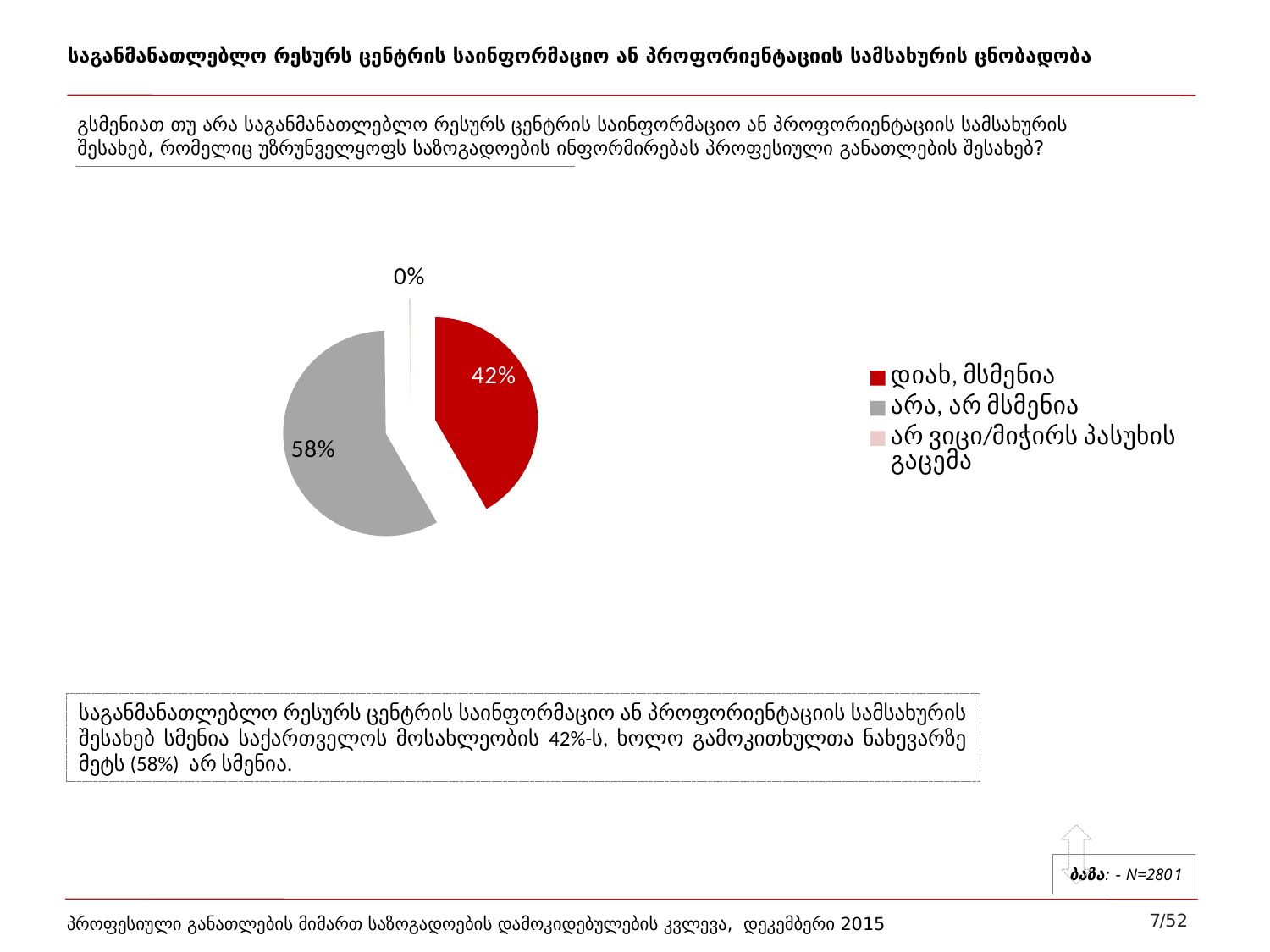
How many entries does the legend list? 3 How many categories does the pie chart show? 3 What percentage is shown for "არ ვიცი/მიჭირს პასუხის გაცემა"? 0% What type of chart is shown on the slide? Pie chart What percentage of the pie chart is labelled "არა, არ მსმენია"? 58% What percentage of the pie chart is labelled "დიახ, მსმენია"? 42% What colour is the slice for "არა, არ მსმენია"? Gray What colour is the slice for "დიახ, მსმენია"? Red Which is larger: the share for "დიახ, მსმენია" or the share for "არა, არ მსმენია"? არა, არ მსმენია What is the difference in percentage points between "არა, არ მსმენია" and "დიახ, მსმენია"? 16 Which category has the largest share of the pie chart? არა, არ მსმენია Which category has the smallest share of the pie chart? არ ვიცი/მიჭირს პასუხის გაცემა